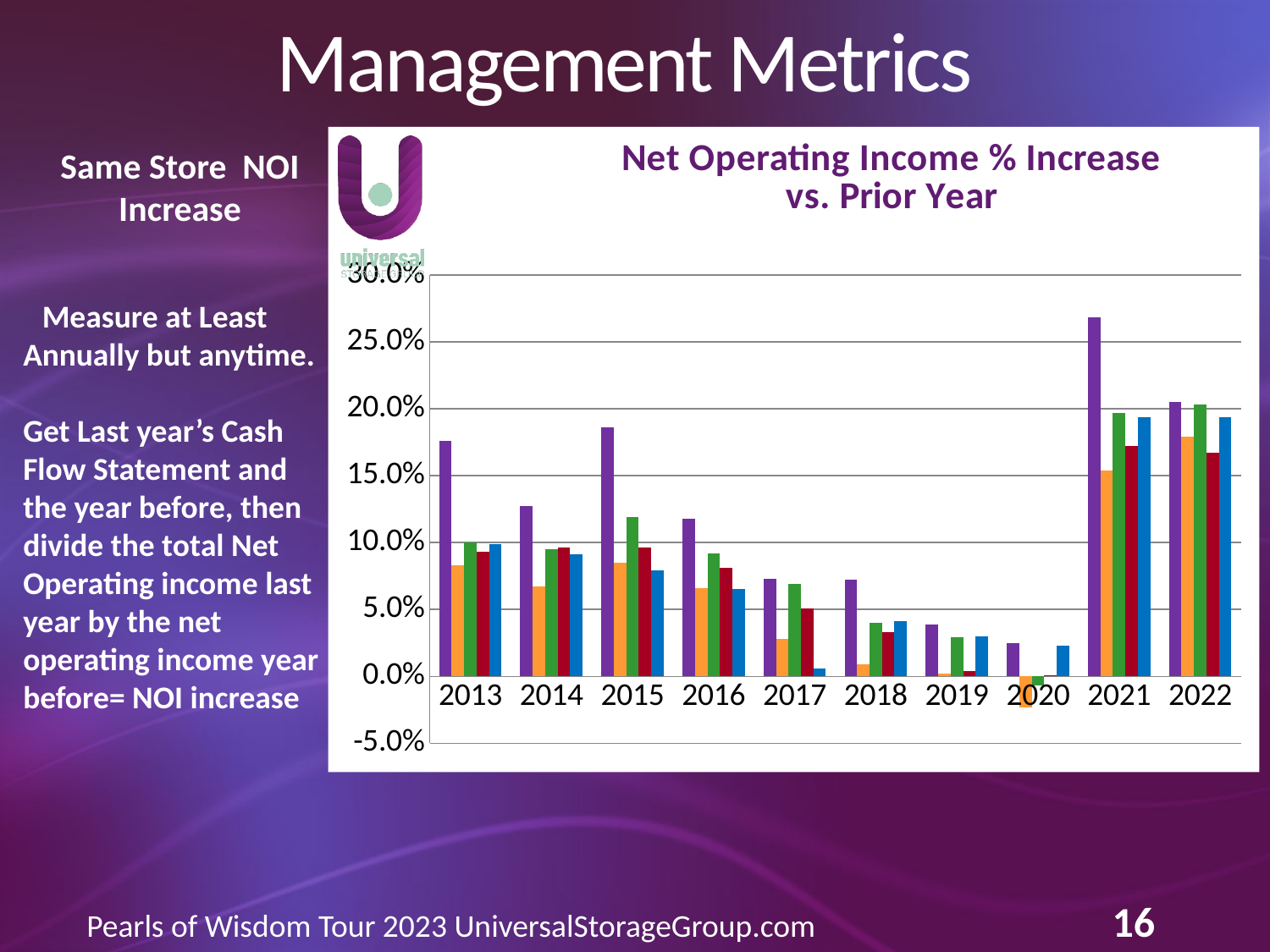
What is the highest value shown on the y axis of the chart? 30.0% Is the value of the orange bar for 2020 greater or less than 0.0%? less What is the title of the chart? Net Operating Income % Increase vs. Prior Year Which is larger, the purple bar for 2013 or the purple bar for 2014? 2013 Is the value of the purple bar for 2013 greater or less than 15.0%? greater Is the value of the blue bar for 2017 greater or less than 5.0%? less Which year contains the tallest bar in the chart? 2021 What kind of chart is shown on the slide? bar chart How many years are shown on the x axis of the chart? 10 Which year contains the lowest bar in the chart? 2020